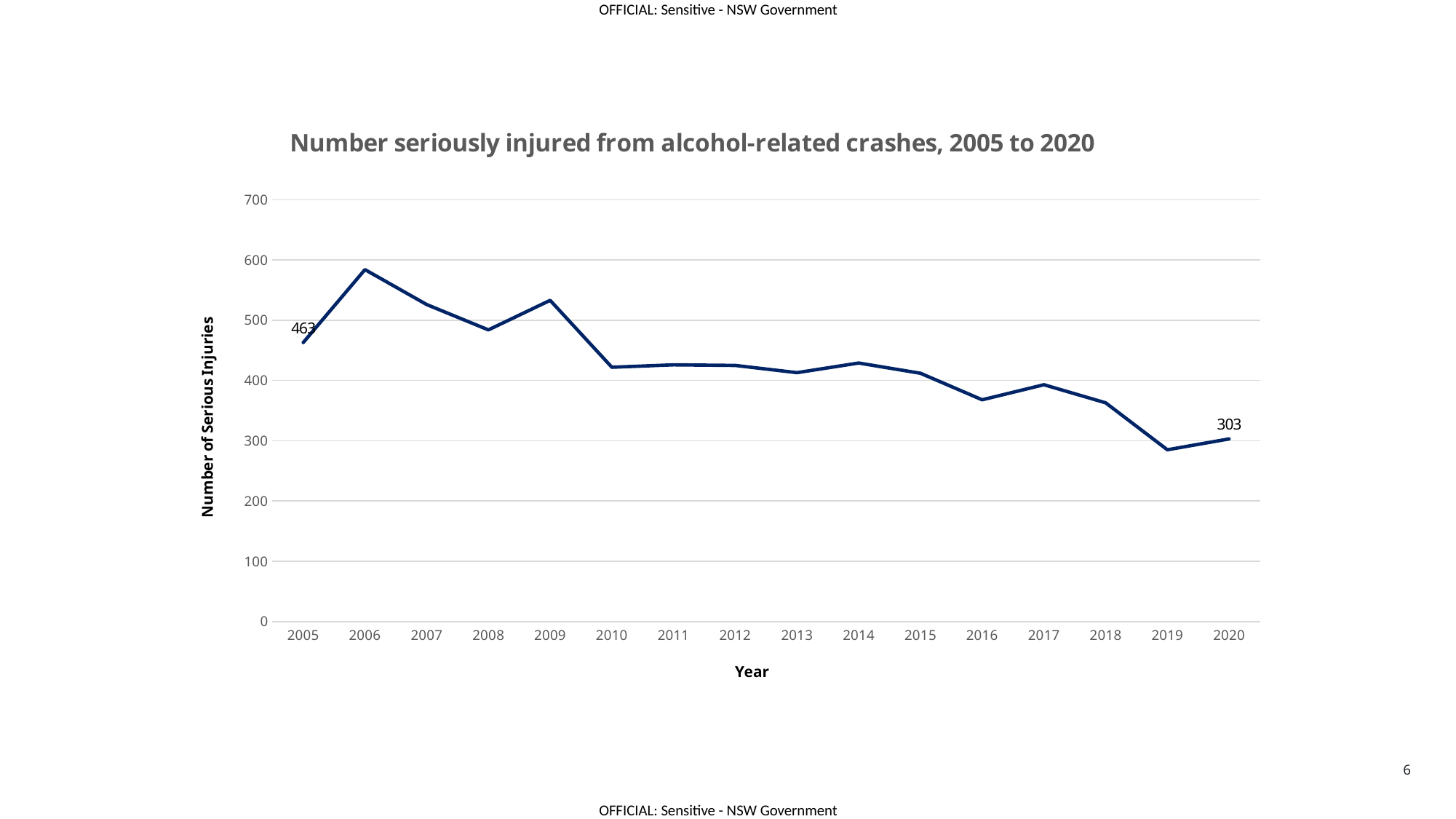
What kind of chart is shown on the slide? line chart How many years are plotted on the x axis? 16 What is the difference between the number seriously injured in 2005 and in 2020? 160 What is the title of the chart? Number seriously injured from alcohol-related crashes, 2005 to 2020 What is the number of serious injuries from alcohol-related crashes in 2005? 463 Is the value for 2019 greater or less than 300? less Overall, do the values rise or fall from 2005 to 2020? fall Is the value for 2006 greater or less than 500? greater What is the number of serious injuries from alcohol-related crashes in 2020? 303 Which year has the highest number of serious injuries? 2006 Which year has more serious injuries, 2009 or 2010? 2009 Which year has the lowest number of serious injuries? 2019